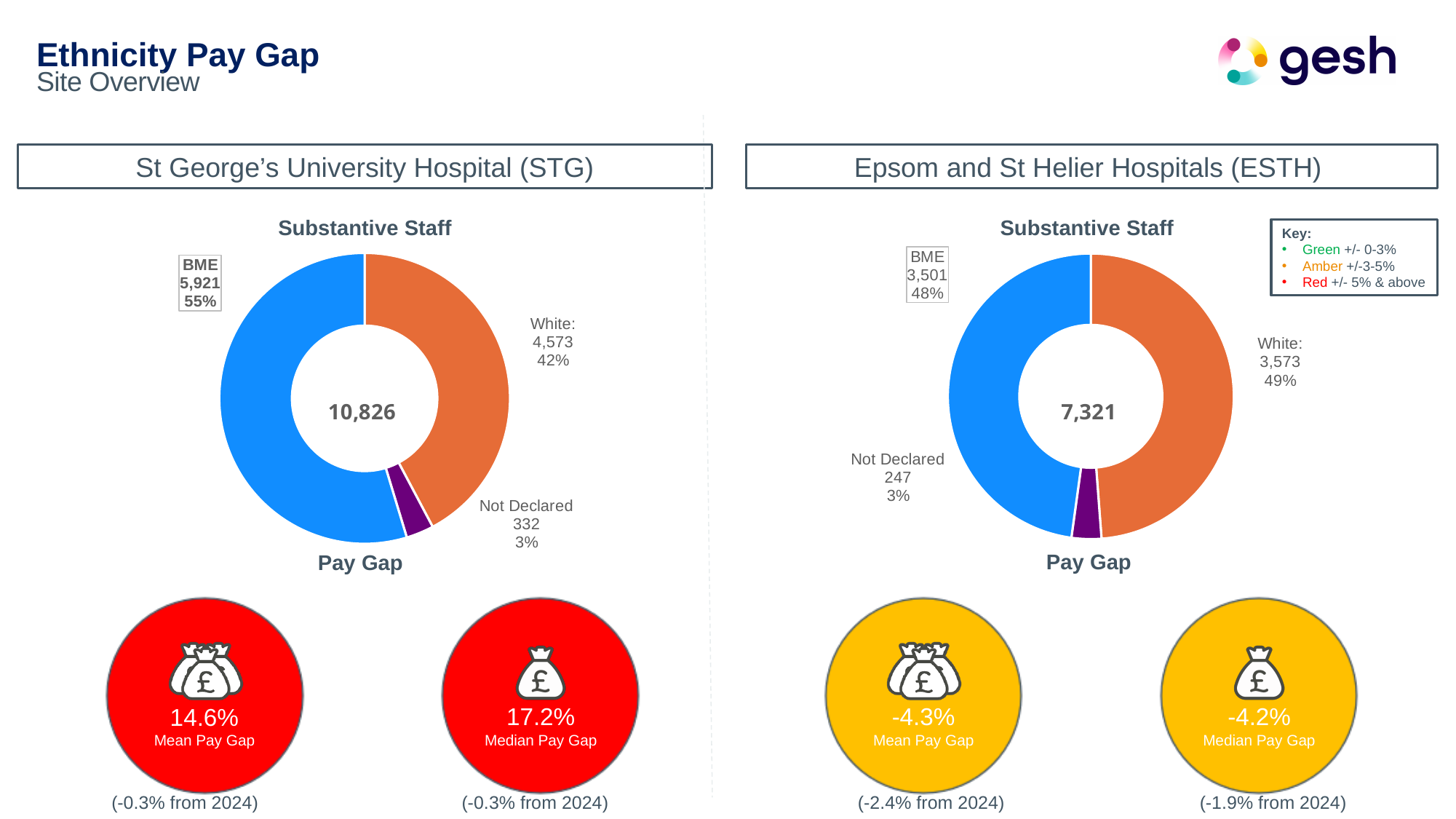
How many categories does the St George's University Hospital (STG) Substantive Staff chart show? 3 In the St George's University Hospital (STG) Substantive Staff chart, what colour is the BME segment? Blue In the St George's University Hospital (STG) Substantive Staff chart, how many BME staff are there? 5,921 In the Epsom and St Helier Hospitals (ESTH) Substantive Staff chart, which is larger, the number of White staff or BME staff? White What total is shown in the centre of the Epsom and St Helier Hospitals (ESTH) Substantive Staff chart? 7,321 In the St George's University Hospital (STG) Substantive Staff chart, how many staff are Not Declared? 332 In the Epsom and St Helier Hospitals (ESTH) Substantive Staff chart, which category has the smallest number of staff? Not Declared In the St George's University Hospital (STG) Substantive Staff chart, which category has the largest number of staff? BME What kind of chart is used for Substantive Staff on the slide? Doughnut chart In the Epsom and St Helier Hospitals (ESTH) Substantive Staff chart, what share of staff is Not Declared? 3% In the St George's University Hospital (STG) Substantive Staff chart, what is the difference between the number of BME staff and White staff? 1,348 In the Epsom and St Helier Hospitals (ESTH) Substantive Staff chart, what share of staff is White? 49%